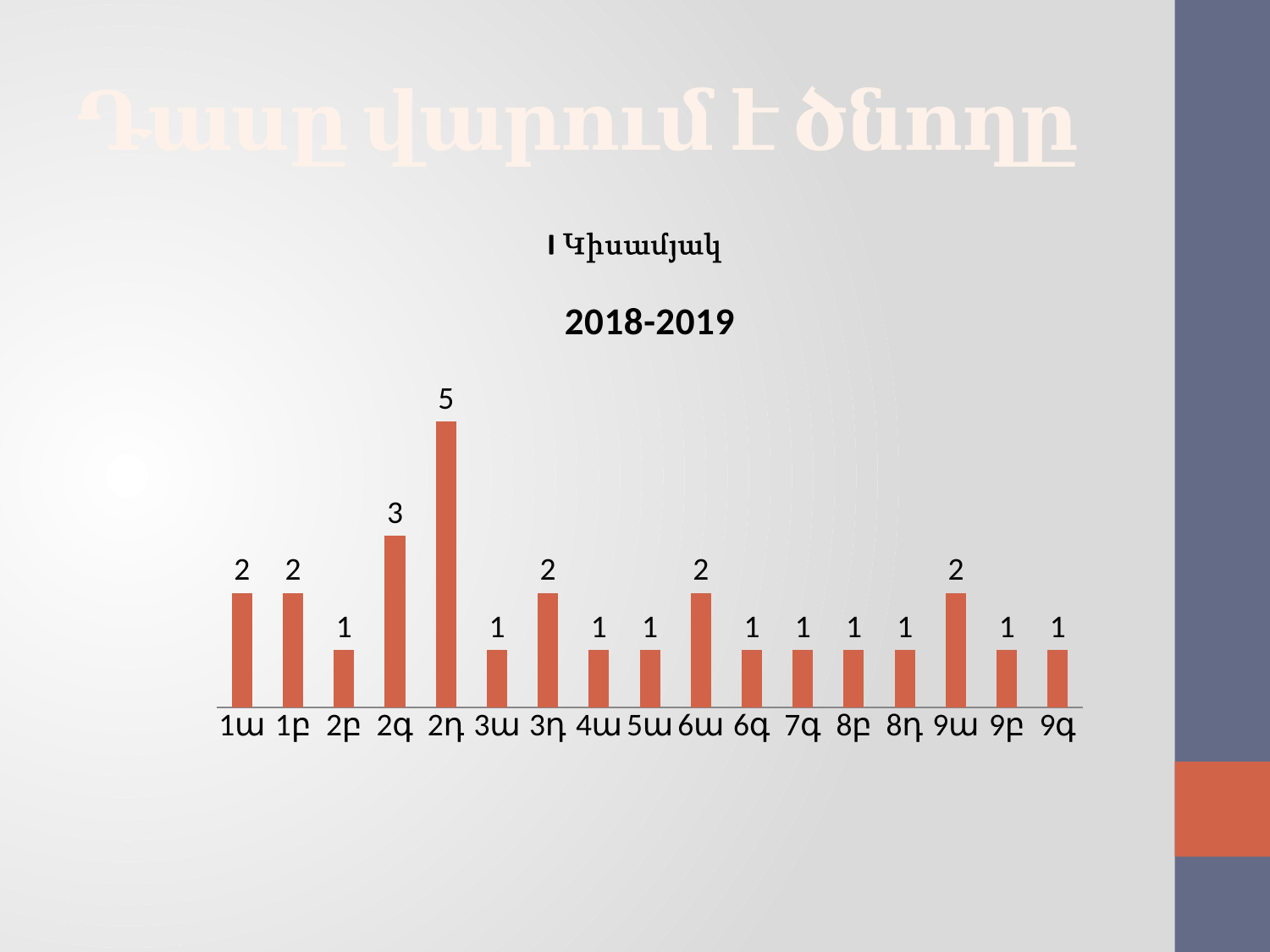
What is the value for 2դ? 5 Which category has the highest value? 2դ Which is larger, the value for 3դ or the value for 3ա? 3դ What is the difference between the values for 1ա and 2բ? 1 What is the difference between the values for 2դ and 2գ? 2 What is the value for 9ա? 2 What is the value for 2գ? 3 What is the value for 7գ? 1 What kind of chart is shown on the slide? bar chart Which is larger, the value for 2գ or the value for 6ա? 2գ What is the title of the chart? 2018-2019 How many categories are shown on the x axis? 17